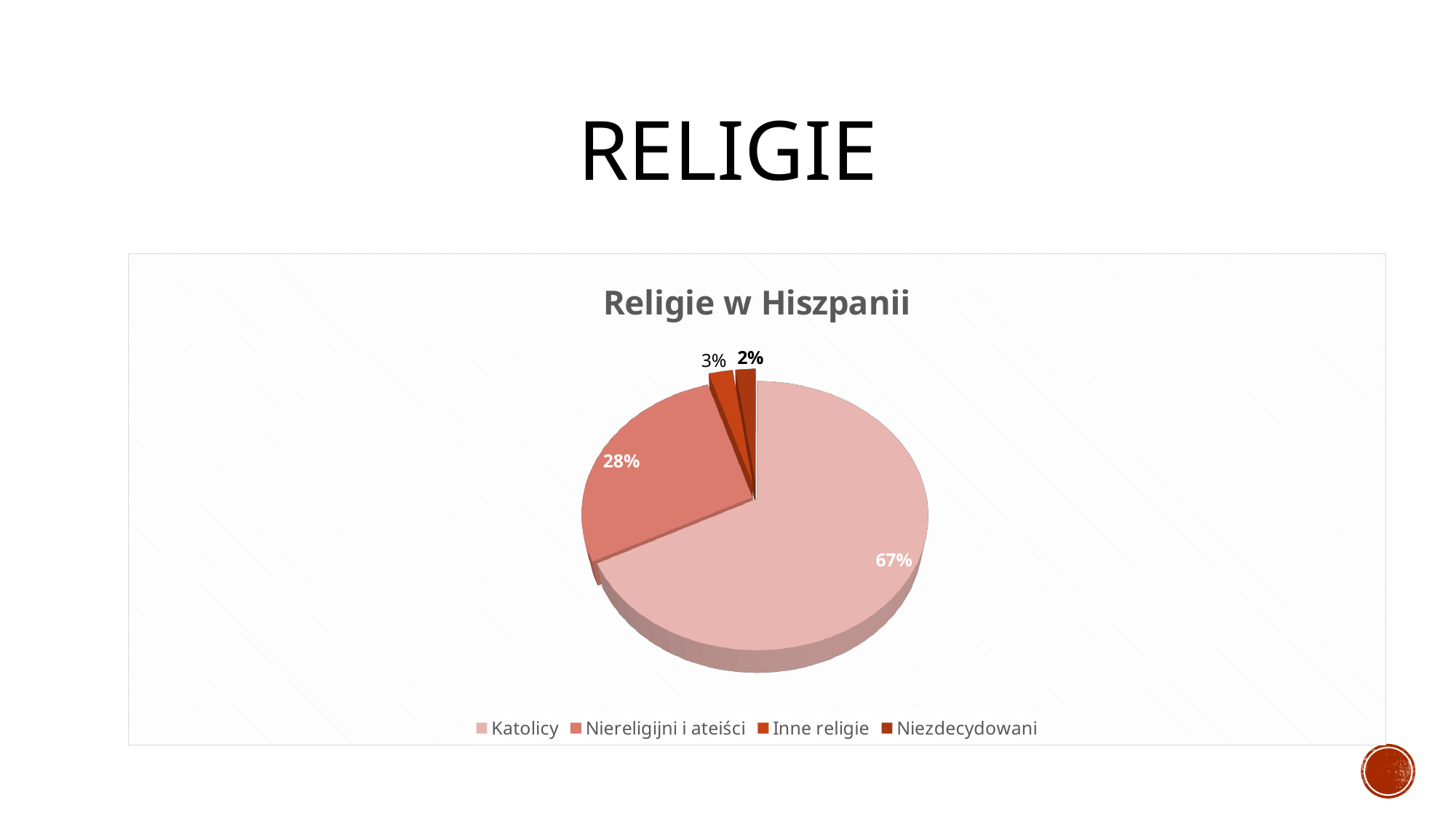
What share of the pie is Inne religie? 3% What share of the pie is Katolicy? 67% How many categories does the legend list? 4 Which category has the largest slice of the pie? Katolicy Which category has the smallest slice of the pie? Niezdecydowani Which is larger, the share of Inne religie or the share of Niezdecydowani? Inne religie What is the difference between the shares of Katolicy and Niereligijni i ateiści? 39% What is the combined share of Inne religie and Niezdecydowani? 5% What kind of chart is shown on the slide? pie chart What is the title of the chart? Religie w Hiszpanii What share of the pie is Niezdecydowani? 2%